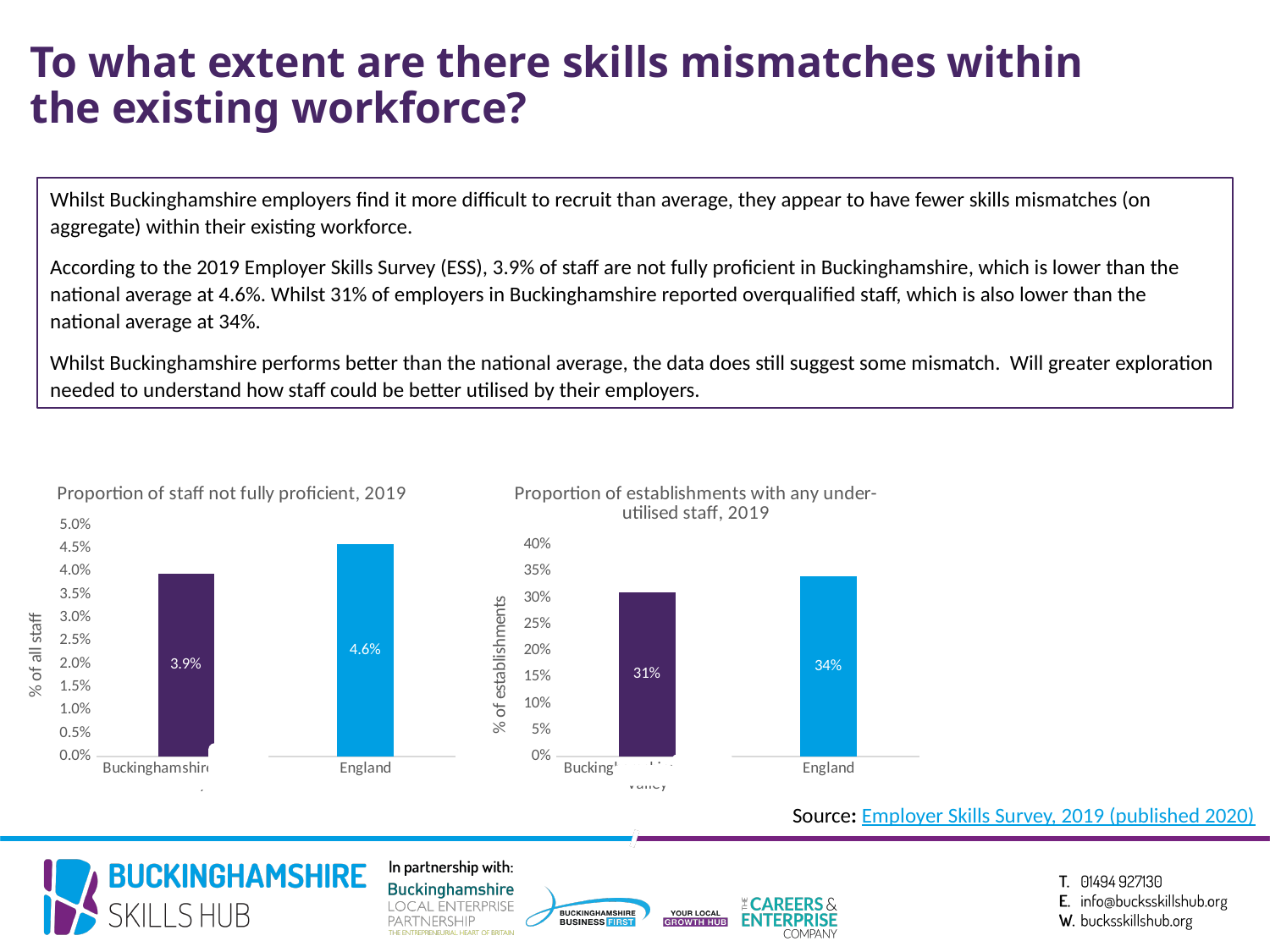
What is the y-axis label of the chart 'Proportion of establishments with any under-utilised staff, 2019'? % of establishments In the chart 'Proportion of establishments with any under-utilised staff, 2019', what is the value for the Buckinghamshire bar? 31% In the chart 'Proportion of establishments with any under-utilised staff, 2019', what is the difference between the England and Buckinghamshire values? 3 percentage points In the chart 'Proportion of staff not fully proficient, 2019', which category has the higher value? England What type of chart is 'Proportion of staff not fully proficient, 2019'? Bar chart In the chart 'Proportion of establishments with any under-utilised staff, 2019', what is the value for England? 34% In the chart 'Proportion of staff not fully proficient, 2019', what is the value for Buckinghamshire? 3.9% In the chart 'Proportion of staff not fully proficient, 2019', is the value for England greater or less than 4.0%? greater In the chart 'Proportion of establishments with any under-utilised staff, 2019', which category has the lower value? Buckinghamshire In the chart 'Proportion of staff not fully proficient, 2019', what is the difference between the England and Buckinghamshire values? 0.7 percentage points How many categories are shown in the chart 'Proportion of establishments with any under-utilised staff, 2019'? 2 In the chart 'Proportion of staff not fully proficient, 2019', what is the value for England? 4.6%